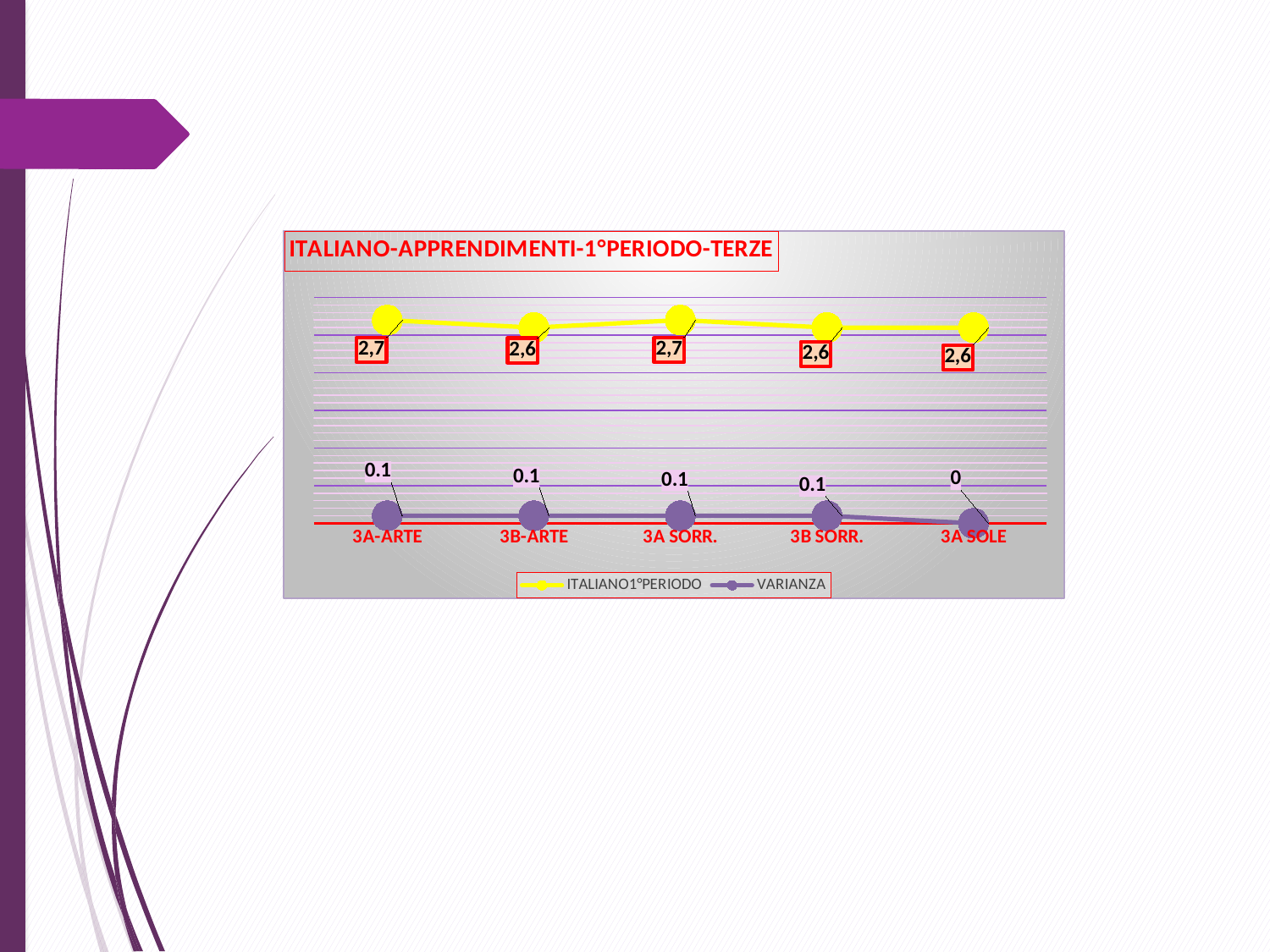
What is the ITALIANO1°PERIODO value for 3B SORR.? 2,6 Which colour is used for the VARIANZA series? Purple What is the ITALIANO1°PERIODO value for 3A-ARTE? 2,7 How many series does the legend list? 2 What is the difference between the ITALIANO1°PERIODO values for 3A SORR. and 3B SORR.? 0,1 What is the VARIANZA value for 3B-ARTE? 0.1 Which has the larger ITALIANO1°PERIODO value, 3A-ARTE or 3B-ARTE? 3A-ARTE What kind of chart is shown on the slide? Line chart What is the title of the chart? ITALIANO-APPRENDIMENTI-1°PERIODO-TERZE How many categories are shown on the x axis? 5 Which category has the lowest VARIANZA value? 3A SOLE What is the VARIANZA value for 3A SOLE? 0